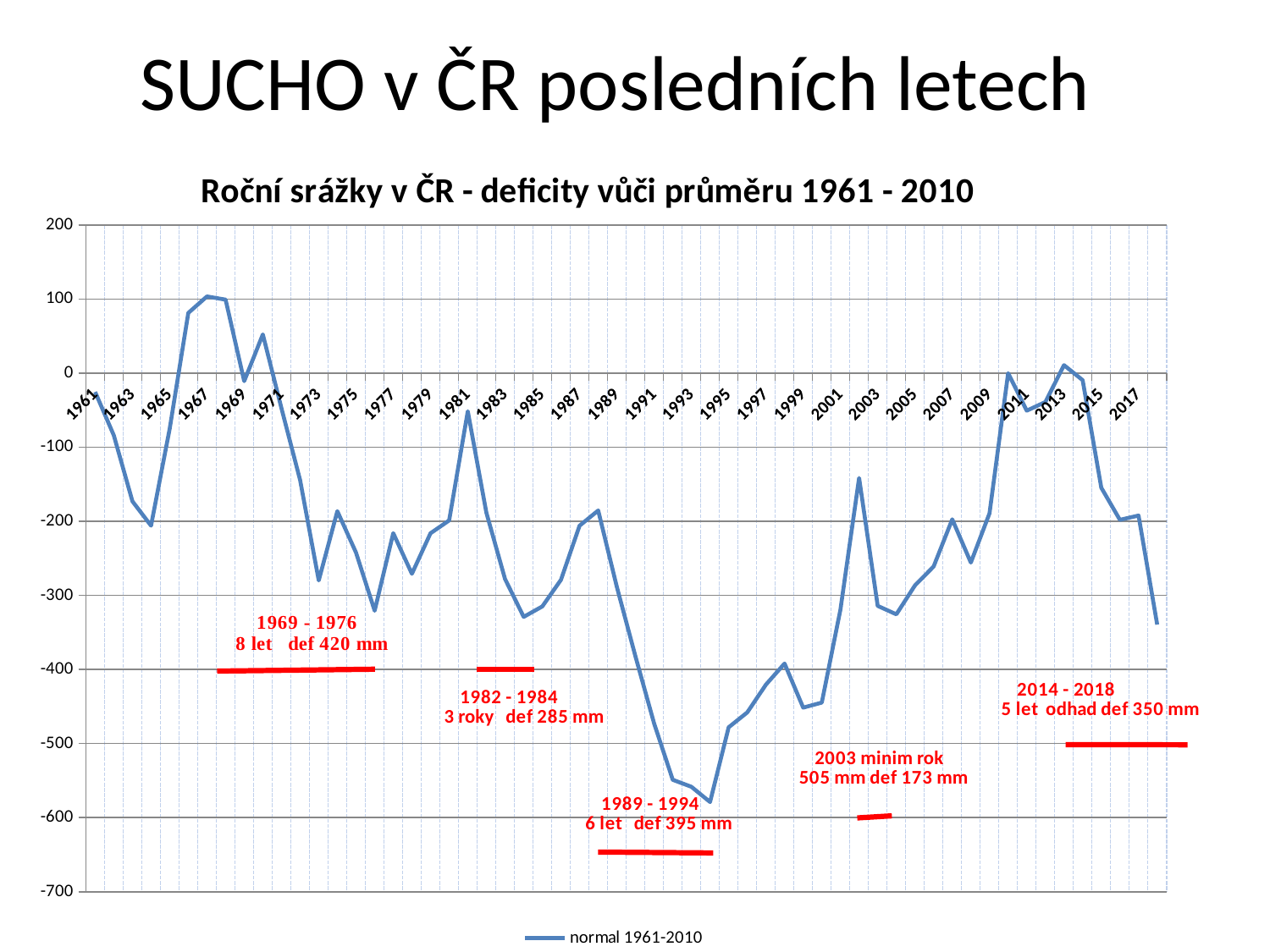
Is the value for 2018 greater or less than -300? less How many series does the legend list? 1 What is the title of the chart? Roční srážky v ČR - deficity vůči průměru 1961 - 2010 Do the values rise or fall along the x axis from 1989 to 1994? fall In which year does the line reach its lowest value? 1994 What kind of chart is shown on the slide? line chart What deficit is stated in the annotation for the period 1969 - 1976? def 420 mm What is the legend entry for the plotted line? normal 1961-2010 Which year has the higher value, 1981 or 1984? 1981 Is the value for 1994 greater or less than -500? less Is the value for 2003 greater or less than -200? less